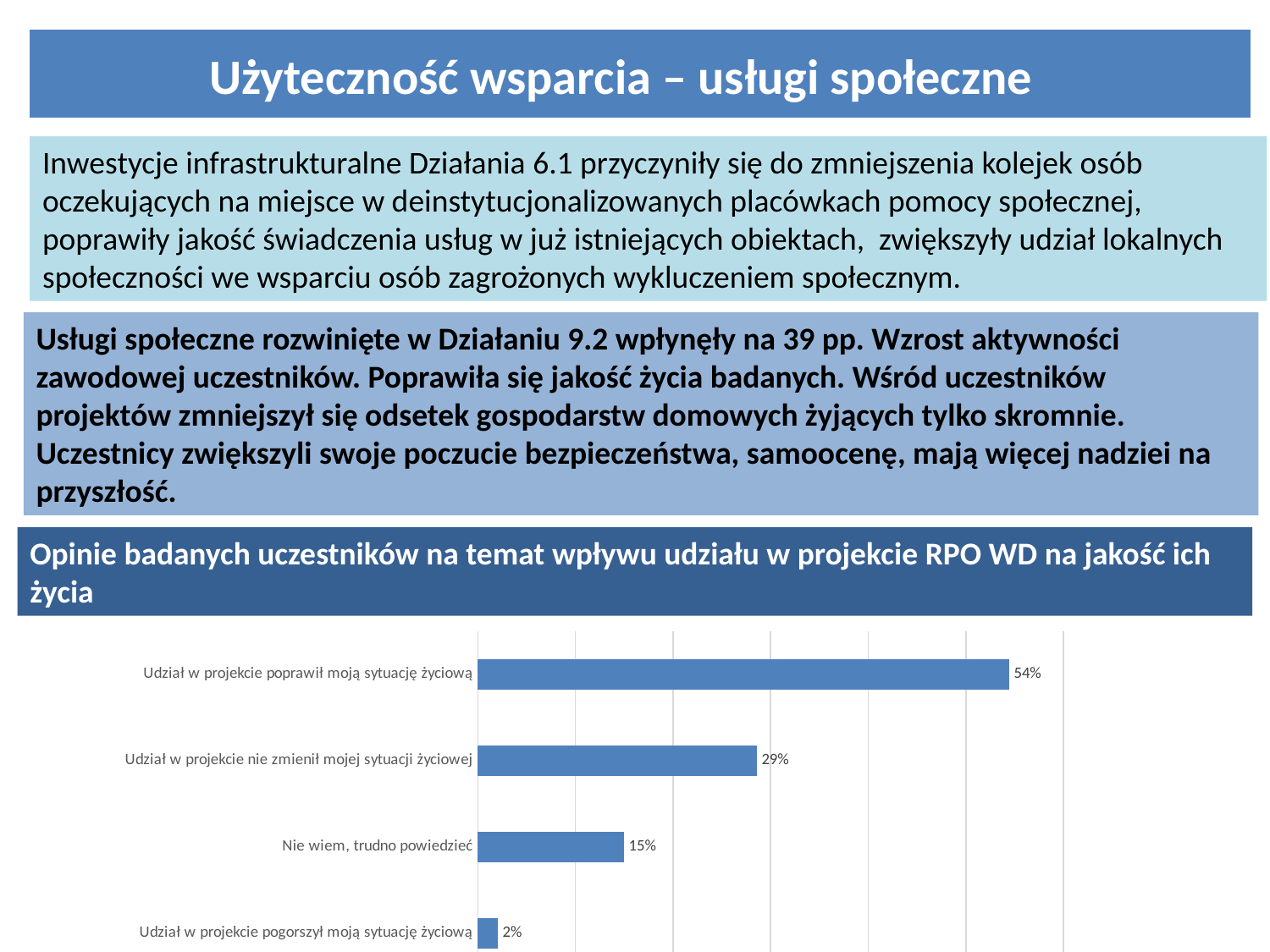
What value is shown for "Udział w projekcie nie zmienił mojej sytuacji życiowej"? 29% What value is shown for "Nie wiem, trudno powiedzieć"? 15% What is the difference between the share who said the project improved their situation and the share who said it did not change their situation? 25 pp What type of chart is shown on the slide? Bar chart Which response category has the lowest value in the chart? Udział w projekcie pogorszył moją sytuację życiową Which is larger: the value for "Udział w projekcie nie zmienił mojej sytuacji życiowej" or for "Nie wiem, trudno powiedzieć"? Udział w projekcie nie zmienił mojej sytuacji życiowej What is the title of the chart on the slide? Opinie badanych uczestników na temat wpływu udziału w projekcie RPO WD na jakość ich życia What percentage of respondents said participation in the project improved their life situation ("Udział w projekcie poprawił moją sytuację życiową")? 54% What percentage of respondents said participation in the project worsened their life situation ("Udział w projekcie pogorszył moją sytuację życiową")? 2% How many response categories are shown in the chart? 4 What is the difference between "Nie wiem, trudno powiedzieć" and "Udział w projekcie pogorszył moją sytuację życiową"? 13 pp Which response category has the highest value in the chart? Udział w projekcie poprawił moją sytuację życiową